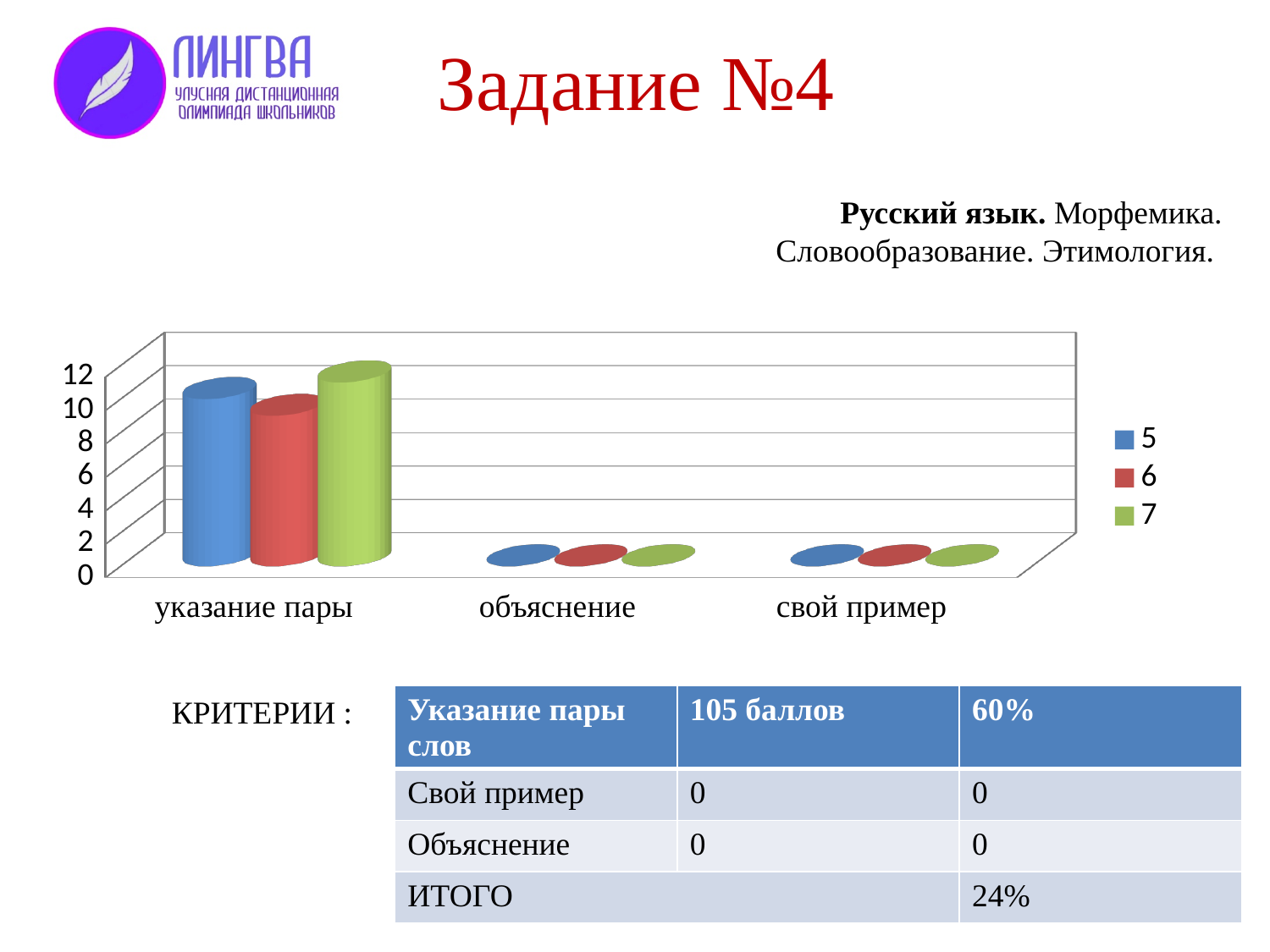
For the category 'указание пары', which series has the highest bar? 7 For the category 'указание пары', is the bar for series 7 larger or smaller than the bar for series 6? larger What are the series names listed in the chart legend? 5, 6, 7 How many categories are shown on the x axis of the chart? 3 Is the value for series 6 in 'указание пары' greater or less than 12? less What is the value for series 5 in the category 'объяснение'? 0 What kind of chart is shown on the slide? bar chart What is the value for series 7 in the category 'свой пример'? 0 For the category 'указание пары', which series has the lowest bar? 6 Which category has the tallest bars in the chart? указание пары How many series does the chart legend list? 3 Is the value for series 5 in 'указание пары' greater or less than 6? greater